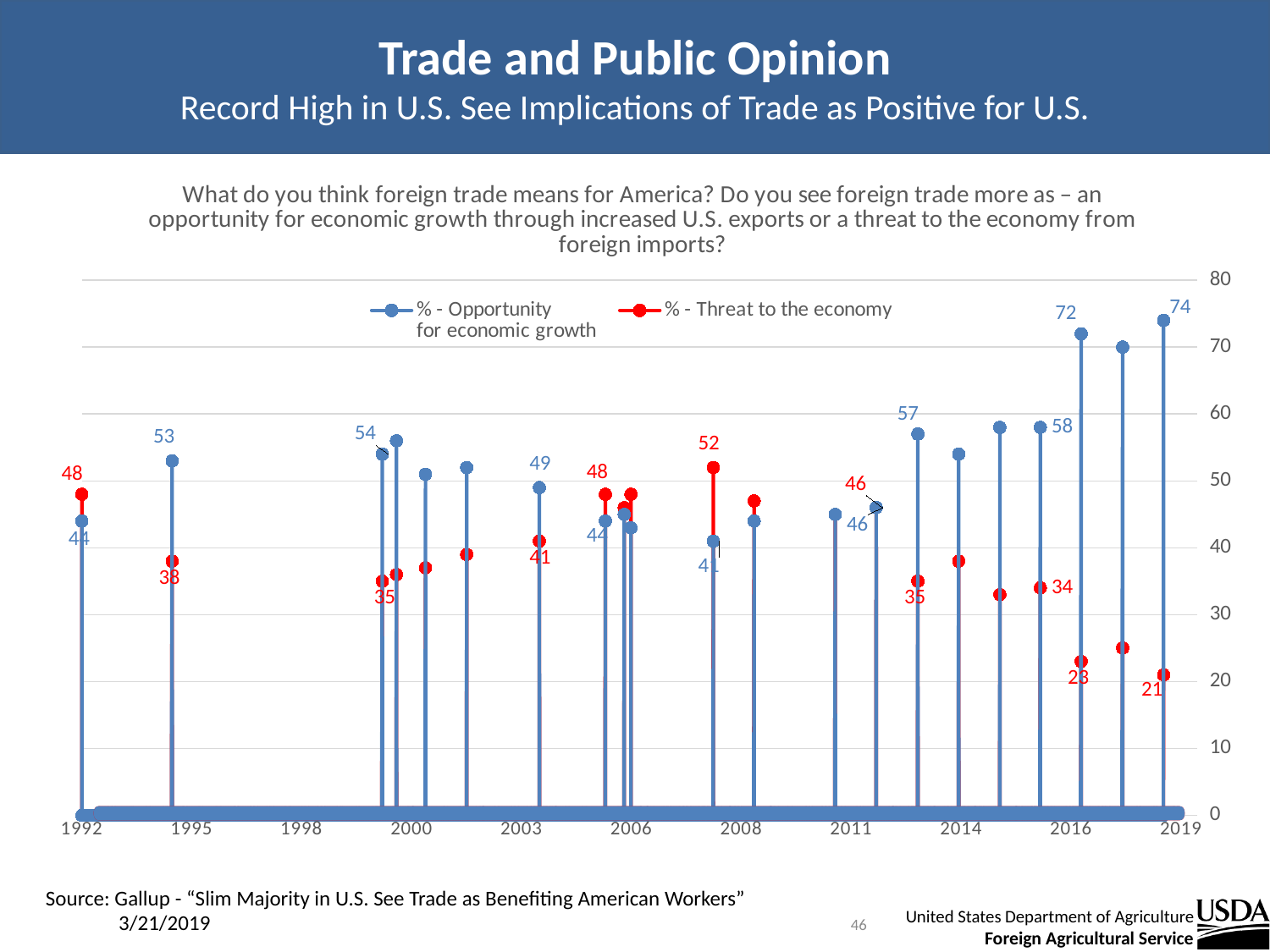
Overall, does the '% - Opportunity for economic growth' series rise or fall from 1992 to 2019? rise What is the value of the '% - Threat to the economy' series in 2019? 21 How many series does the chart legend list? 2 In 2019, what is the difference between the Opportunity value and the Threat value? 53 What kind of chart is shown on the slide? line chart What is the highest labelled value in the '% - Threat to the economy' series? 52 What colour is used for the '% - Threat to the economy' series? red Is the value for '% - Threat to the economy' in 2019 greater or less than 30? less What is the lowest labelled value in the '% - Threat to the economy' series? 21 What is the highest labelled value in the '% - Opportunity for economic growth' series? 74 In 1992, which series has the larger value, Opportunity for economic growth or Threat to the economy? Threat to the economy What is the value of the '% - Opportunity for economic growth' series in 2019? 74